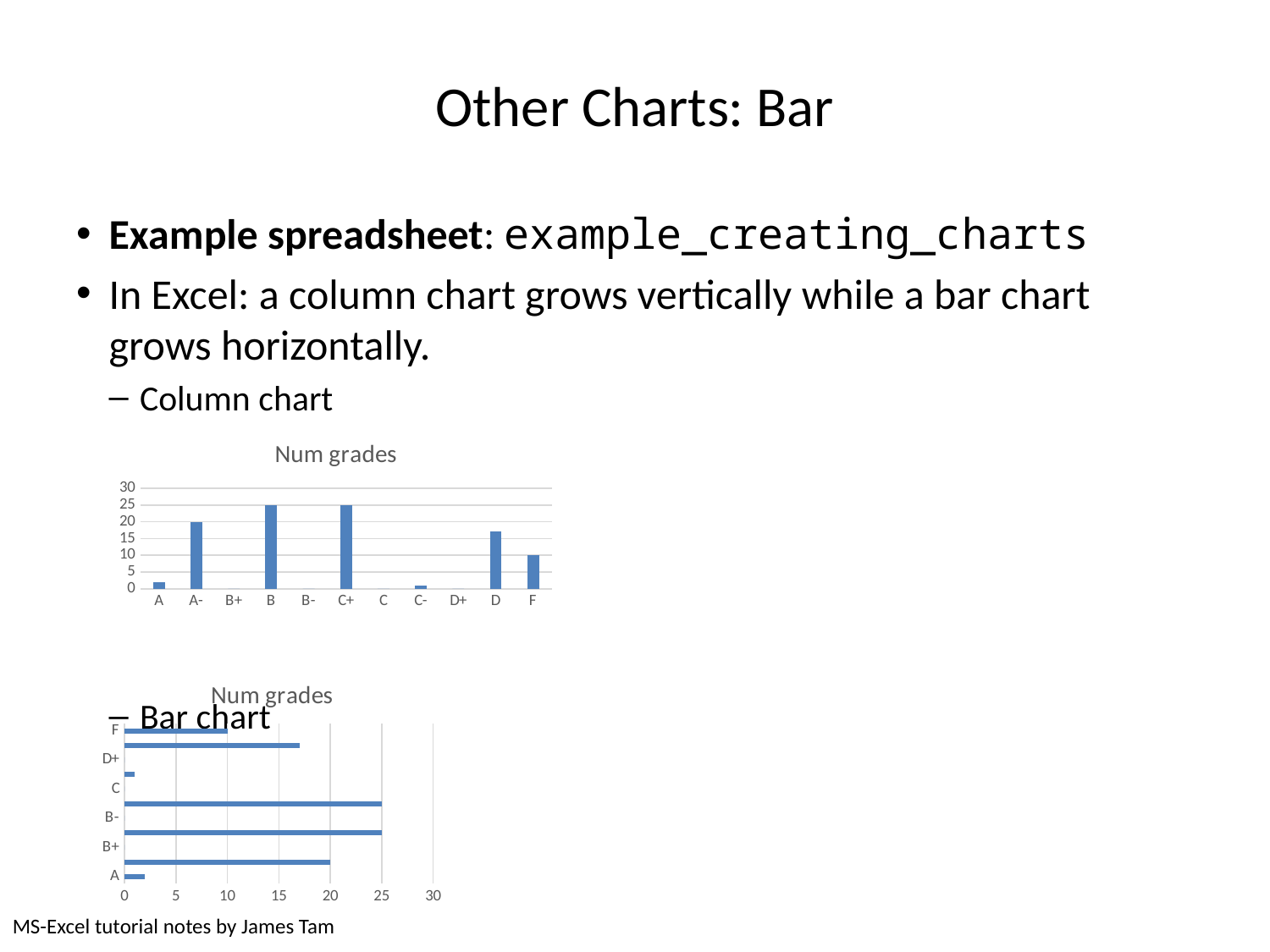
In the top chart, what is the difference between the values for B and F? 15 In the top chart, how many grade categories are shown on the x axis? 11 In the top chart, is the value for A greater or less than 5? less What kind of chart is the bottom chart on the slide? bar chart In the bottom chart, what is the value for F? 10 In the top chart, what is the value for B? 25 In the top chart, is the value for A- greater or less than 15? greater In the top chart, which is larger, the value for B or the value for A? B What is the title of the top chart? Num grades What kind of chart is the top chart on the slide? bar chart